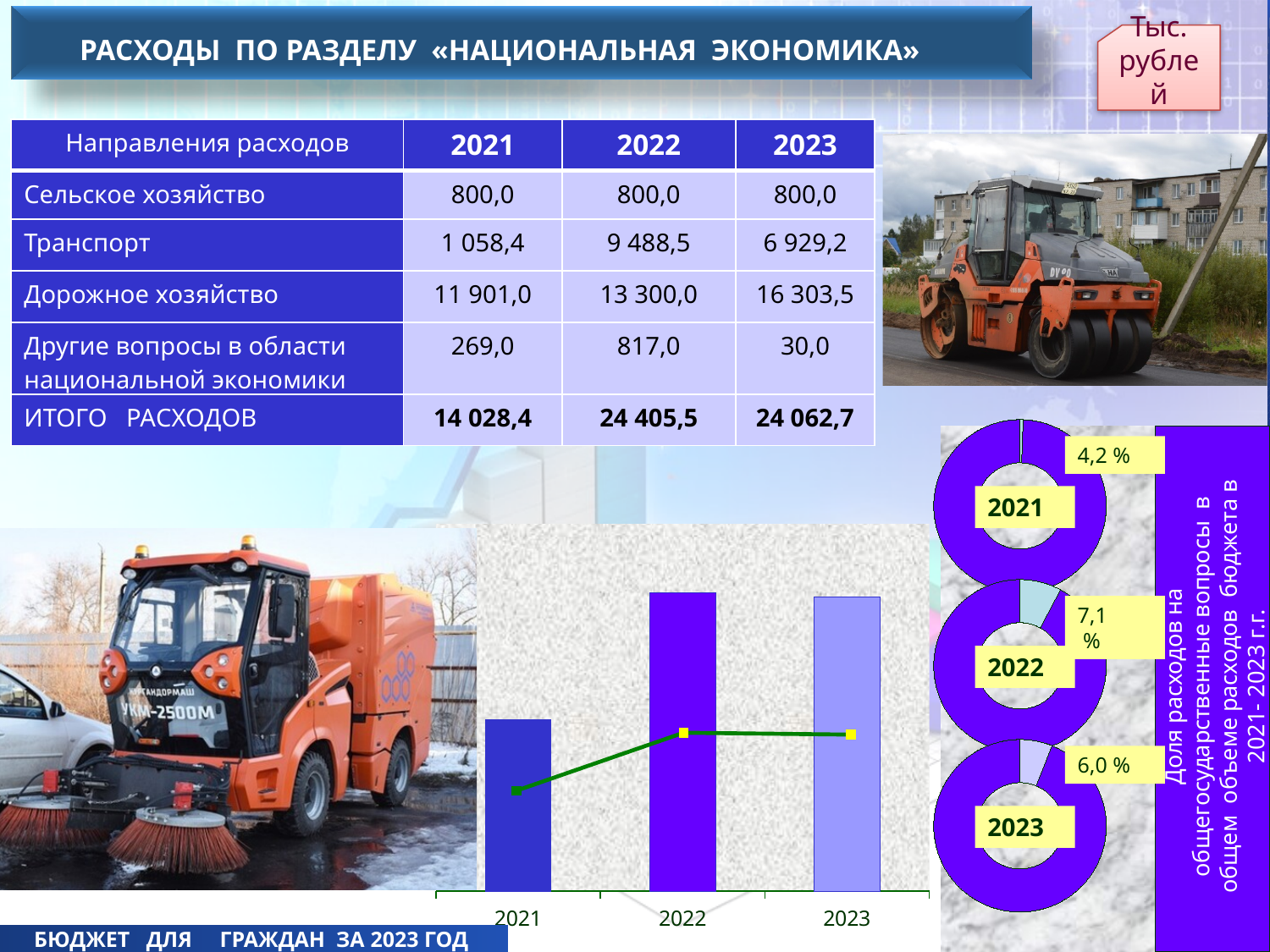
Among the three donut charts on the right, which year has the highest share? 2022 On the donut charts on the right, what is the difference between the share for 2022 and the share for 2021? 2,9 % How many years (categories) are plotted on the bar chart at the bottom centre of the slide? 3 What kind of chart is shown at the bottom centre of the slide, with the years 2021, 2022 and 2023 on the x axis? Bar chart (with a line overlay) On the donut charts on the right, what share is shown for 2021? 4,2 % On the bar chart at the bottom centre, does the bar height rise or fall from 2021 to 2022? Rise On the bar chart at the bottom centre, which bar is taller: 2021 or 2022? 2022 Among the three donut charts on the right, which year has the lowest share? 2021 On the donut charts on the right, what share is shown for 2022? 7,1 % On the donut charts on the right, what share is shown for 2023? 6,0 % How many donut charts are shown on the right side of the slide? 3 On the bar chart at the bottom centre, which year has the lowest bar? 2021